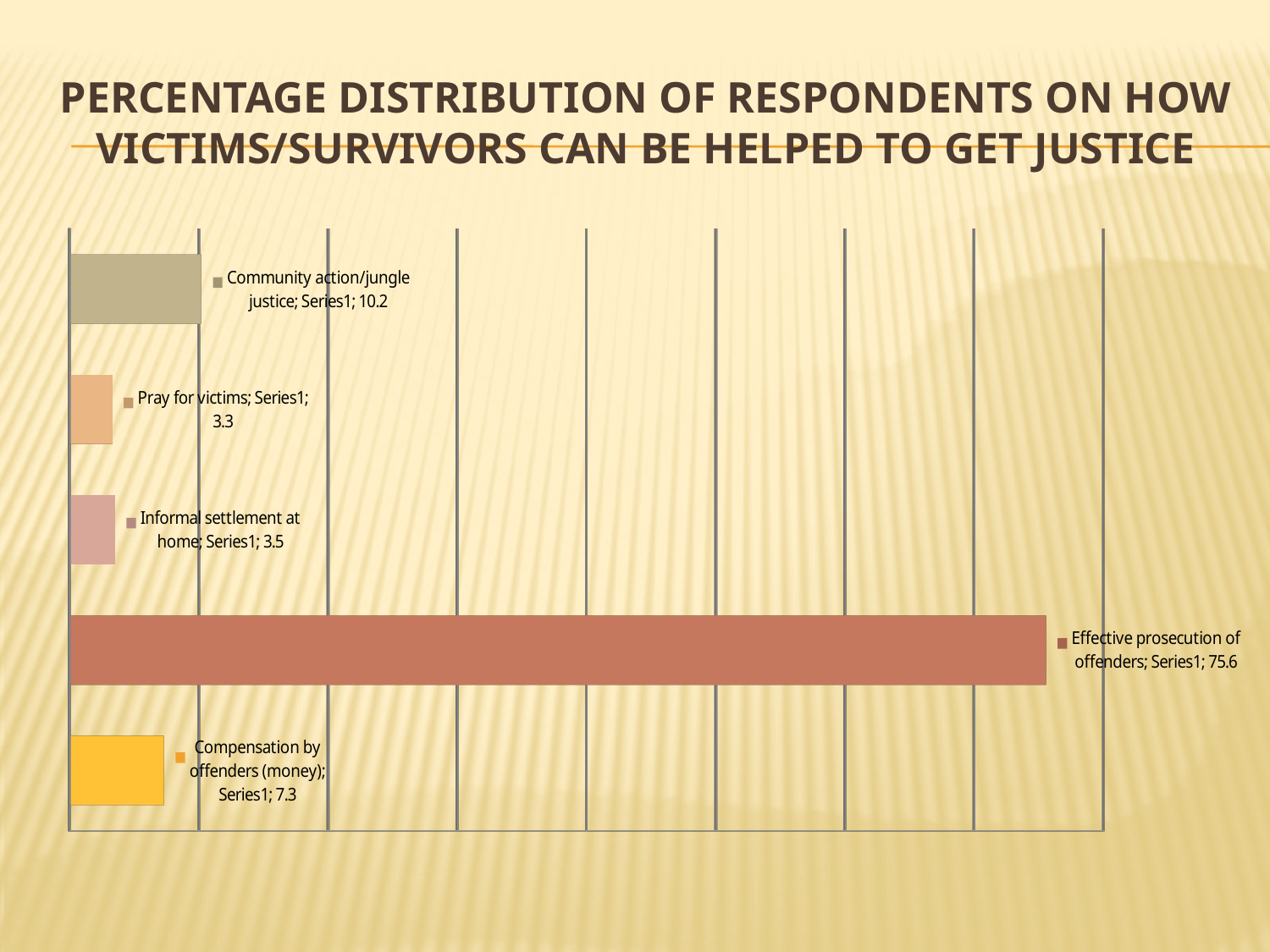
What is the value for Community action/jungle justice? 10.2 Which category has the highest value? Effective prosecution of offenders What is the value for Informal settlement at home? 3.5 What is the title of the slide? Percentage distribution of respondents on how victims/survivors can be helped to get justice Which is larger, the value for Informal settlement at home or the value for Pray for victims? Informal settlement at home What kind of chart is shown on the slide? Bar chart How many categories are shown in the chart? 5 What is the value for Pray for victims? 3.3 What is the value for Effective prosecution of offenders? 75.6 What is the difference between the values for Effective prosecution of offenders and Community action/jungle justice? 65.4 What is the value for Compensation by offenders (money)? 7.3 What is the difference between the values for Community action/jungle justice and Compensation by offenders (money)? 2.9